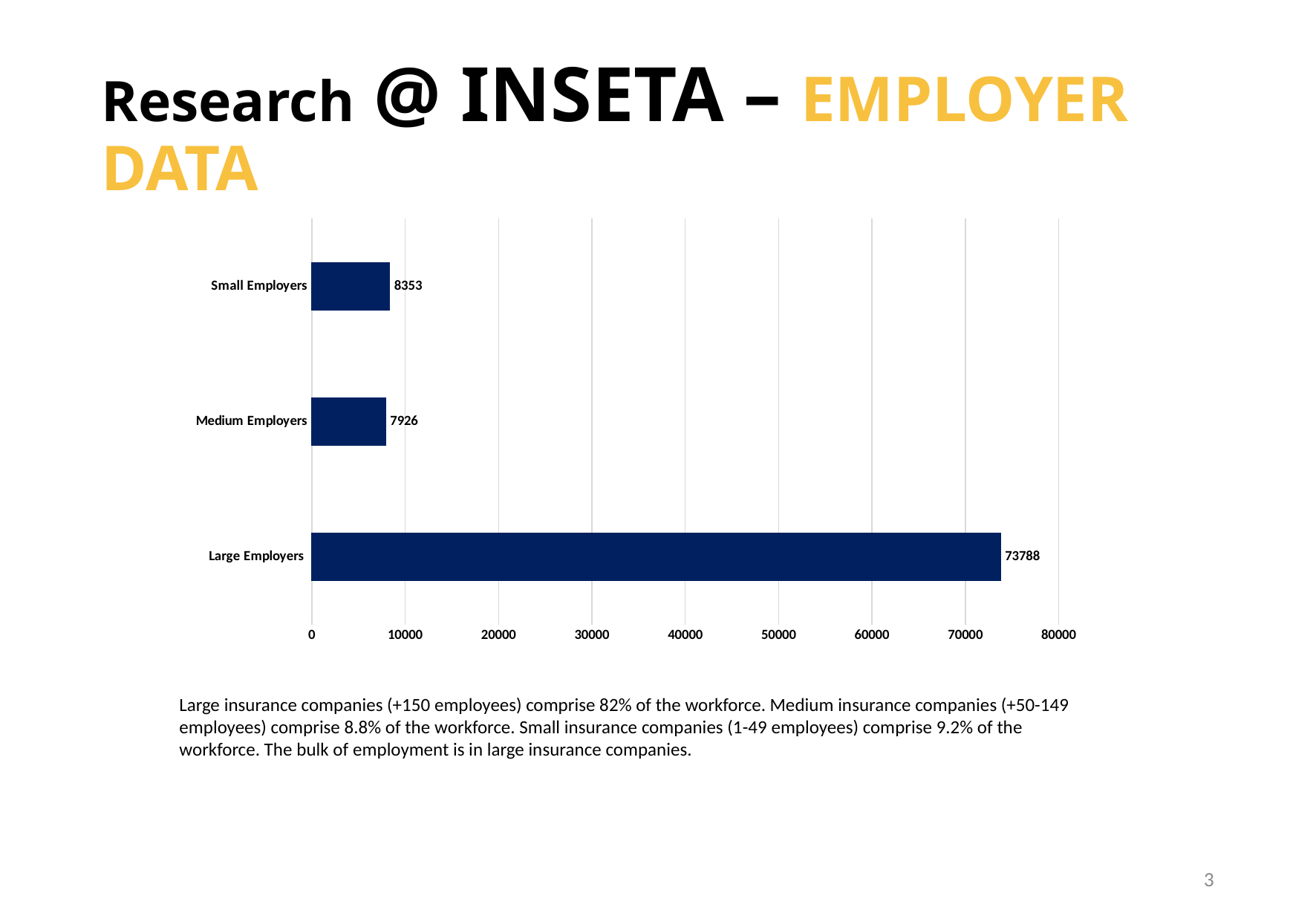
What is the value for Small Employers? 8353 What is the difference between the values for Large Employers and Small Employers? 65435 What kind of chart is shown on the slide? bar chart What is the value for Medium Employers? 7926 Which is larger, the value for Large Employers or the value for Medium Employers? Large Employers How many categories are shown in the chart? 3 What is the value for Large Employers? 73788 Which category has the highest value? Large Employers Which category has the lowest value? Medium Employers Is the value for Medium Employers greater or less than 10000? less Is the value for Large Employers greater or less than 70000? greater What is the difference between the values for Small Employers and Medium Employers? 427